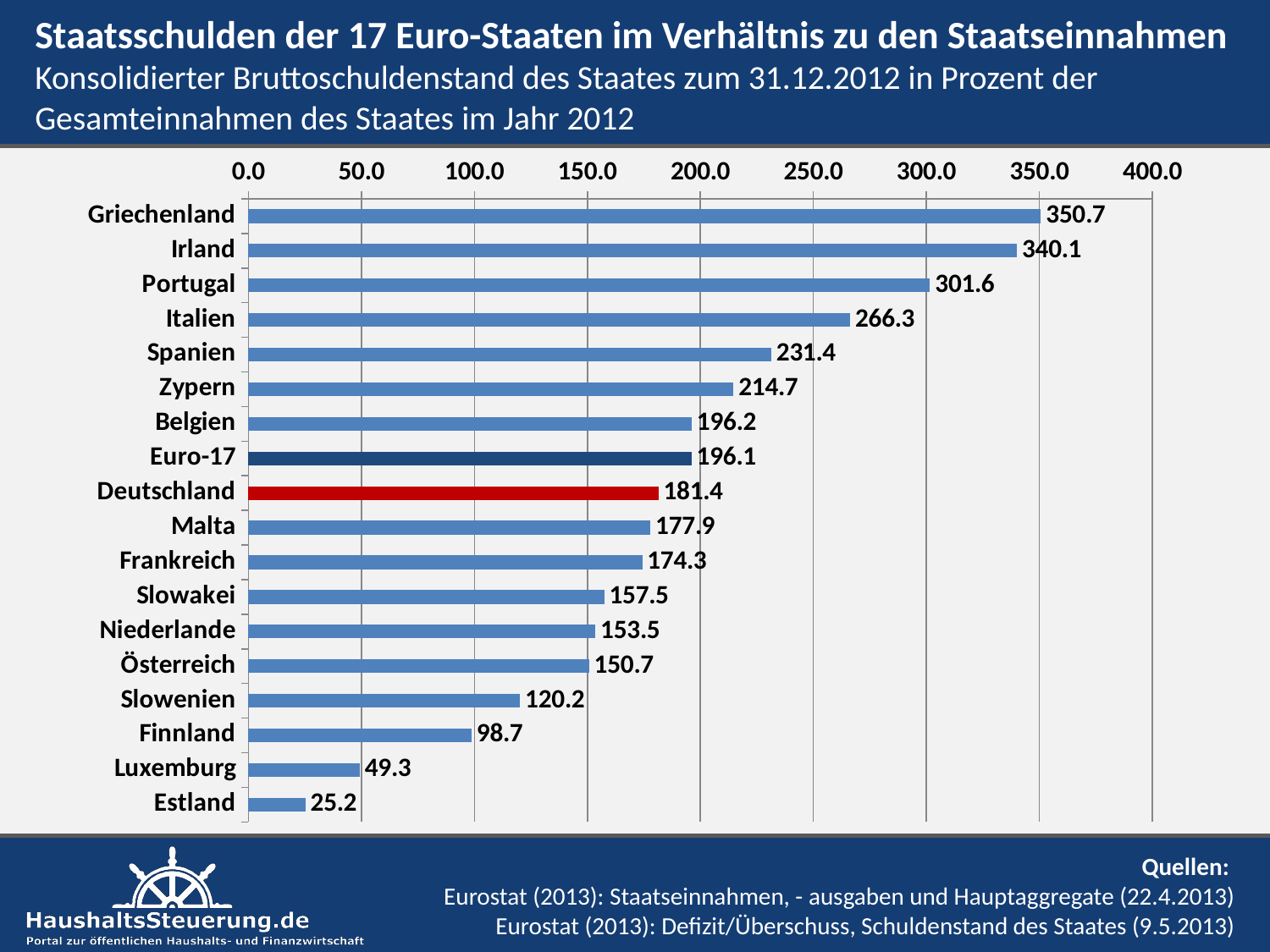
Which category has the lowest value? Estland What is the value shown for Zypern? 214.7 Which category has the highest value? Griechenland What is the difference between the values for Griechenland and Irland? 10.6 What is the value shown for Euro-17? 196.1 What kind of chart is shown on the slide? bar chart What is the value shown for Deutschland? 181.4 Is the value for Spanien greater or less than 200.0? greater How many bars are plotted in the chart? 18 What is the difference between the values for Euro-17 and Deutschland? 14.7 Which has the larger value, Malta or Frankreich? Malta Which bar is coloured red? Deutschland